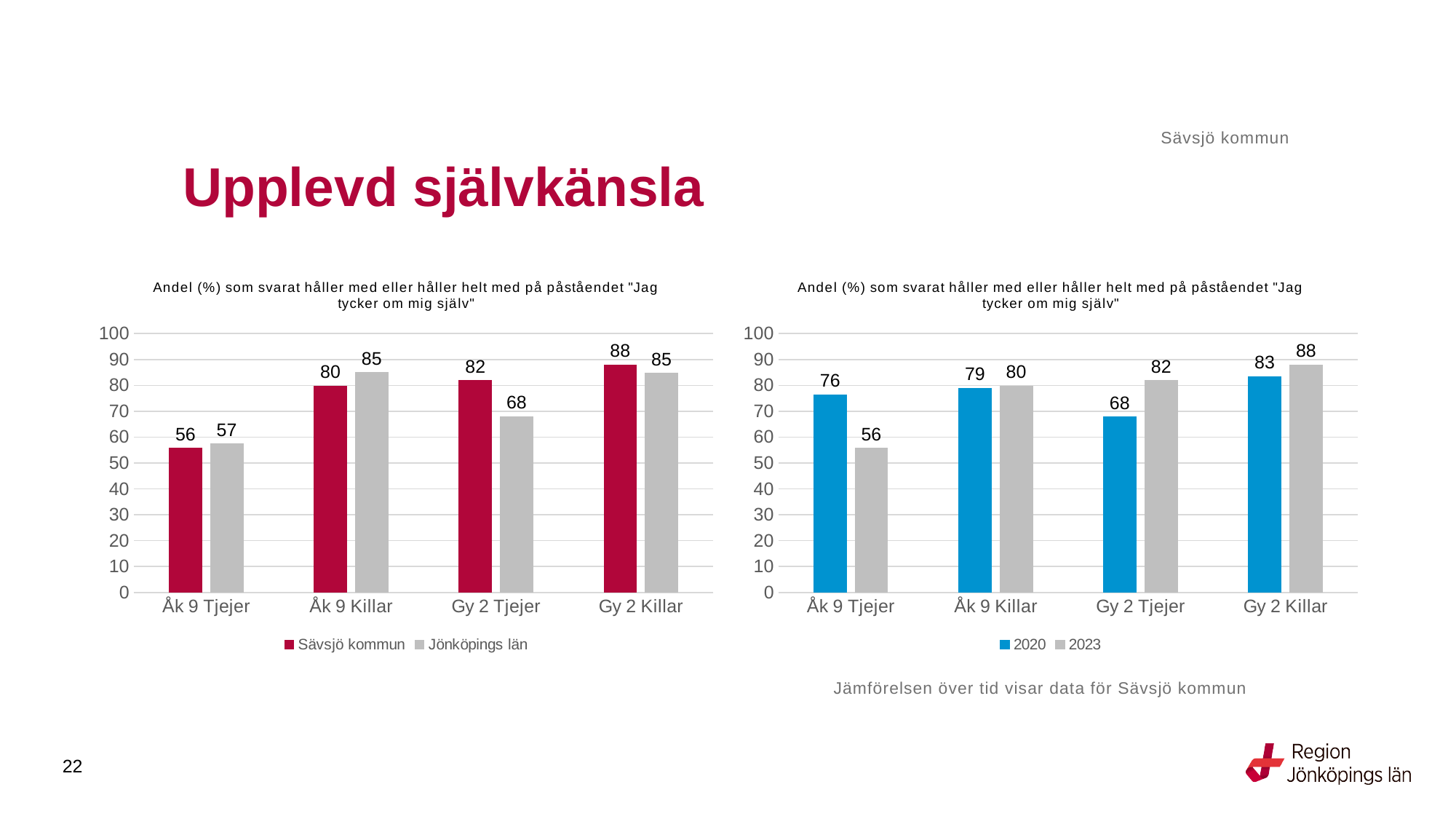
How many series does the legend of the right chart list? 2 In the left chart, which is larger for Åk 9 Killar: Sävsjö kommun or Jönköpings län? Jönköpings län In the right chart, what is the value for 2020 for Åk 9 Tjejer? 76 In the left chart, what is the difference between Sävsjö kommun and Jönköpings län for Gy 2 Tjejer? 14 What kind of chart is the left chart? Bar chart In the left chart, which category has the lowest value for Jönköpings län? Åk 9 Tjejer In the left chart, what is the value for Jönköpings län for Åk 9 Killar? 85 In the right chart, what is the value for 2023 for Gy 2 Killar? 88 In the right chart, what is the difference between 2020 and 2023 for Åk 9 Tjejer? 20 In the left chart, which category has the highest value for Sävsjö kommun? Gy 2 Killar In the right chart, which category has the lowest value for 2020? Gy 2 Tjejer In the left chart, what is the value for Sävsjö kommun for Gy 2 Tjejer? 82